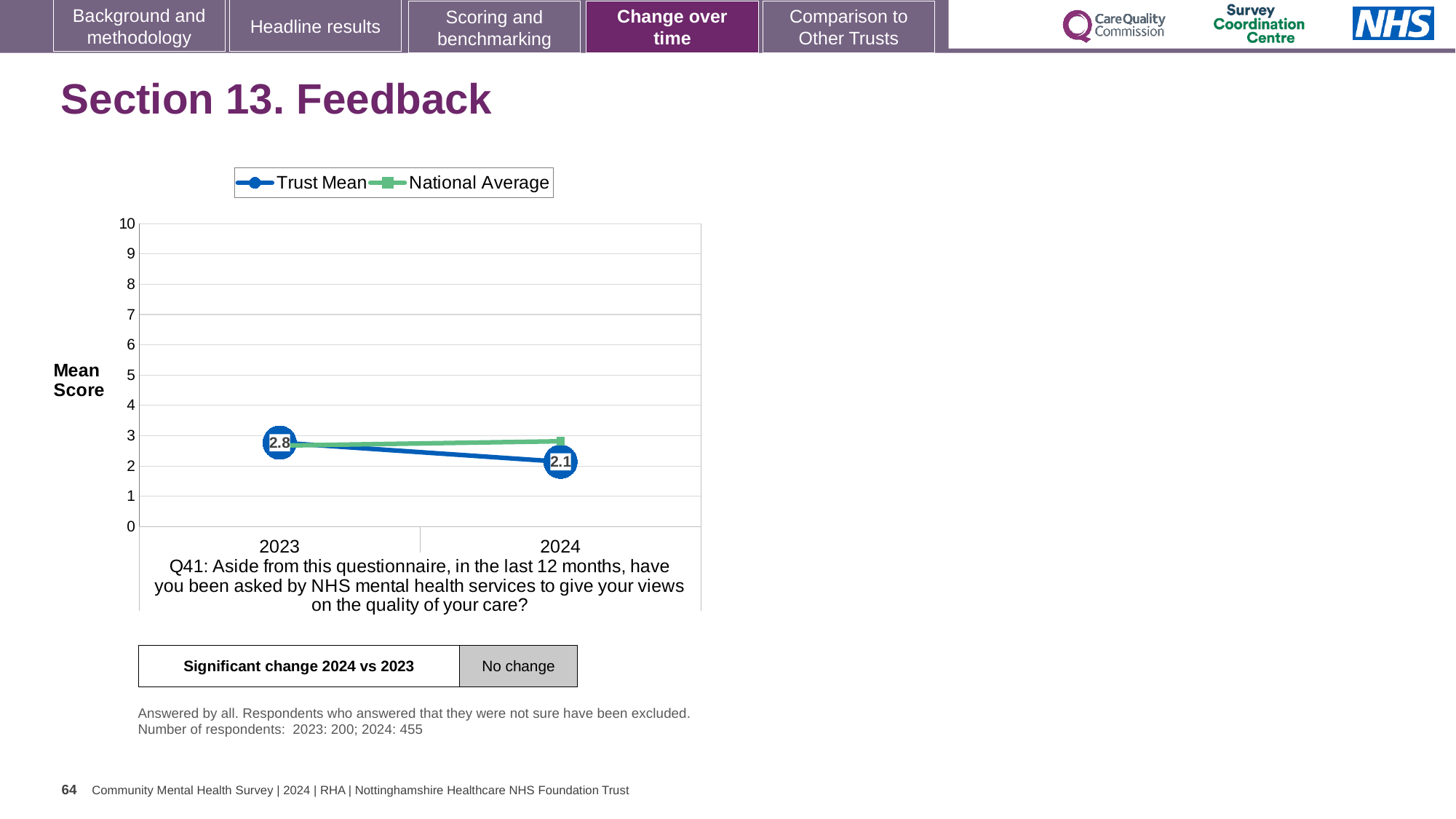
What is the label on the y axis of the chart? Mean Score What is the Trust Mean value for 2023? 2.8 How many series does the legend list? 2 Which year has the higher Trust Mean, 2023 or 2024? 2023 What is the Trust Mean value for 2024? 2.1 Is the Trust Mean value for 2024 greater or less than 3? less What kind of chart is shown on the slide? line chart Is the National Average value for 2024 greater or less than 2? greater Does the Trust Mean rise or fall from 2023 to 2024? fall In 2024, which series is higher, Trust Mean or National Average? National Average By how much did the Trust Mean change from 2023 to 2024? 0.7 How many years are shown on the x axis? 2